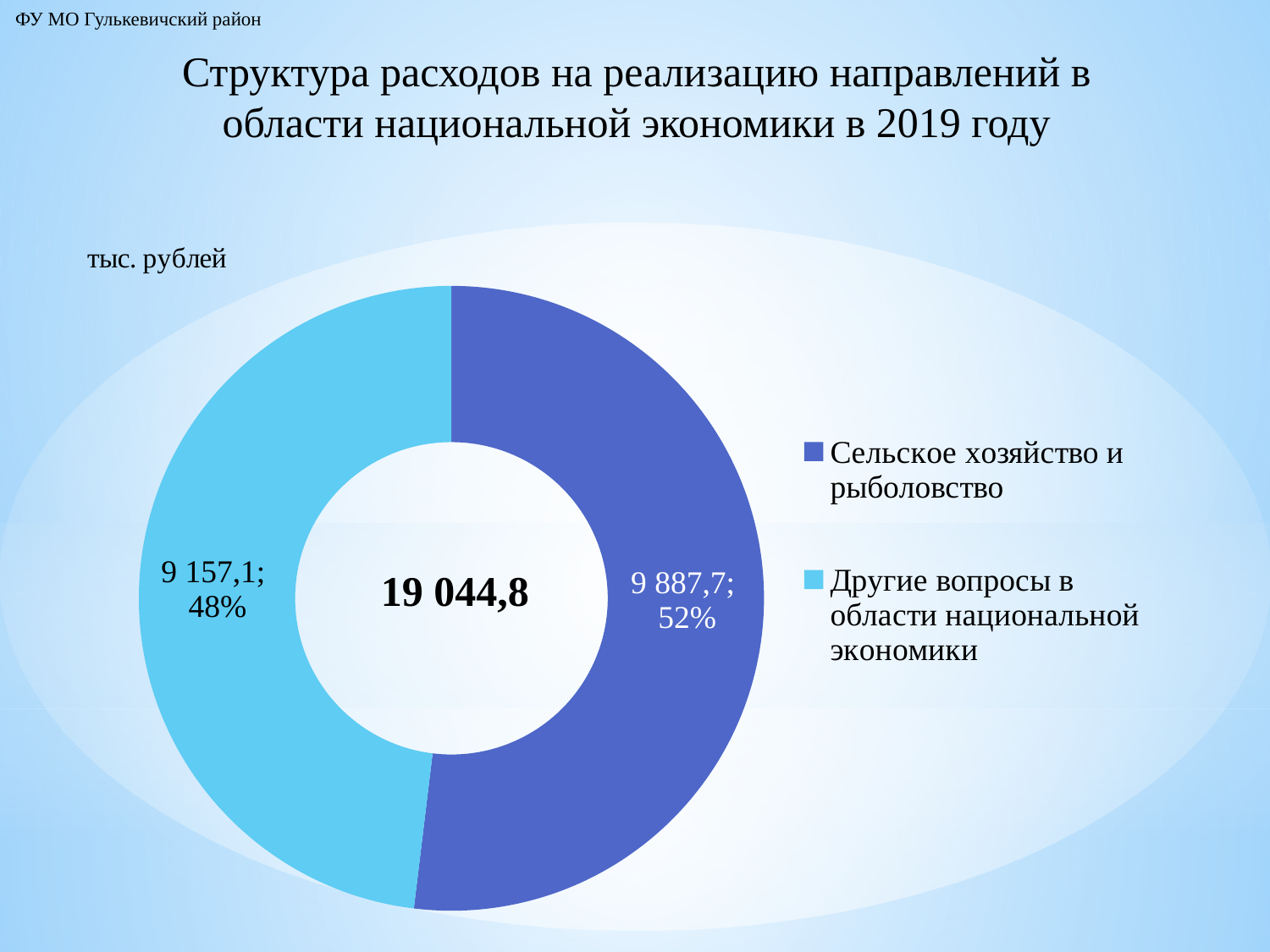
What is the value for Сельское хозяйство и рыболовство? 9 887,7 What is the difference between the values for Сельское хозяйство и рыболовство and Другие вопросы в области национальной экономики? 730,6 What total value is shown in the centre of the chart? 19 044,8 What type of chart is shown on the slide? Doughnut (pie) chart What is the value for Другие вопросы в области национальной экономики? 9 157,1 What share of the chart does Другие вопросы в области национальной экономики represent? 48% Which category has the smallest value? Другие вопросы в области национальной экономики Which category has the largest value? Сельское хозяйство и рыболовство How many categories does the chart show? 2 Which is larger: Сельское хозяйство и рыболовство or Другие вопросы в области национальной экономики? Сельское хозяйство и рыболовство In what units are the chart values given? тыс. рублей What share of the chart does Сельское хозяйство и рыболовство represent? 52%